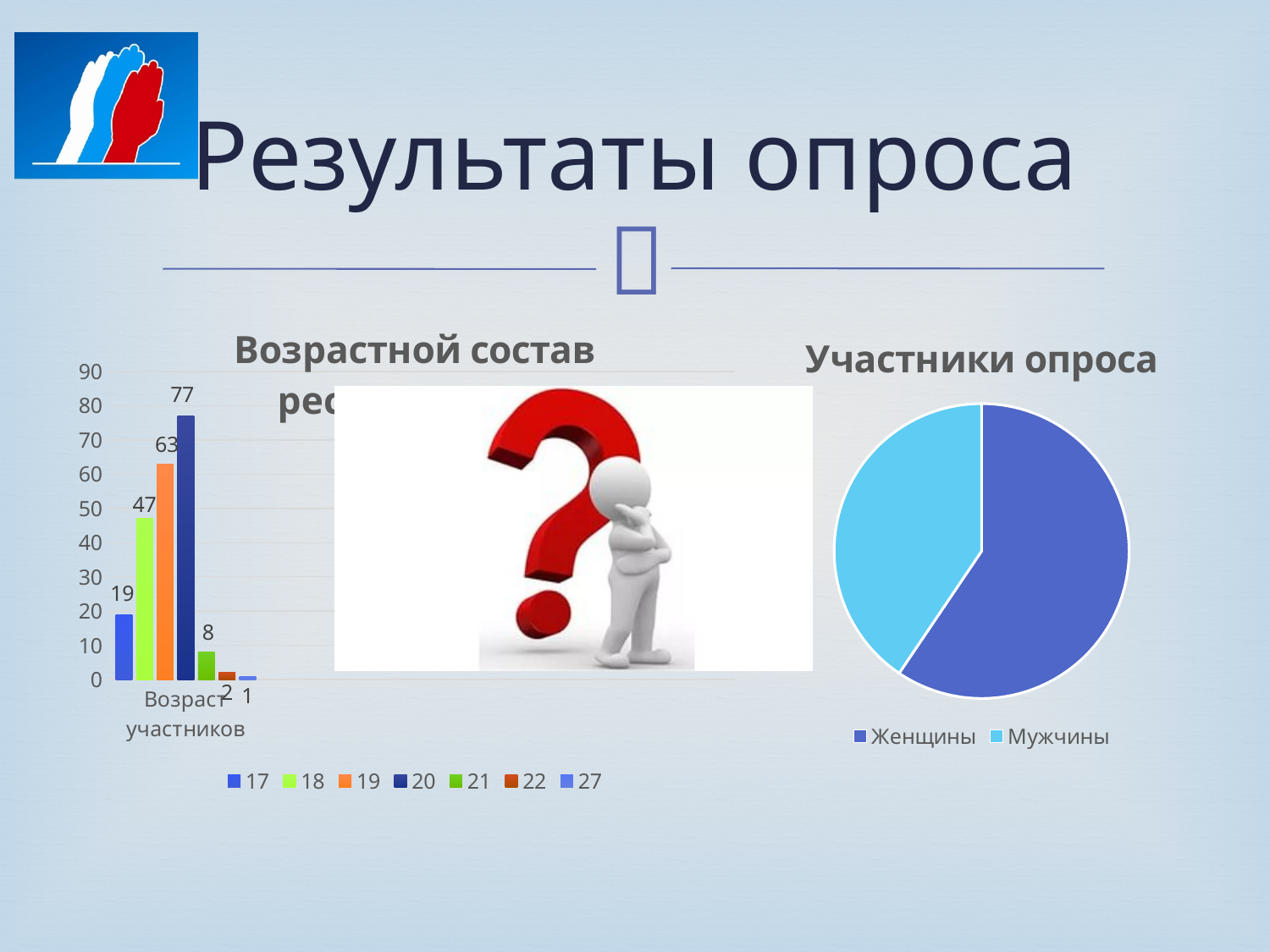
In the bar chart on the left, what is the difference between the values for series 20 and series 19? 14 What kind of chart is the chart titled 'Участники опроса'? pie chart How many series does the legend of the bar chart on the left list? 7 In the bar chart on the left, what is the value for the series 20? 77 In the bar chart on the left, which series has the lowest value? 27 In the bar chart on the left, which series has the highest value? 20 How many slices does the chart titled 'Участники опроса' have? 2 In the chart titled 'Участники опроса', which slice is larger: Женщины or Мужчины? Женщины In the bar chart on the left, what is the value for the series 18? 47 What kind of chart is the chart on the left of the slide? bar chart In the bar chart on the left, what is the value for the series 22? 2 In the bar chart on the left, which is larger: the value for series 17 or series 21? 17